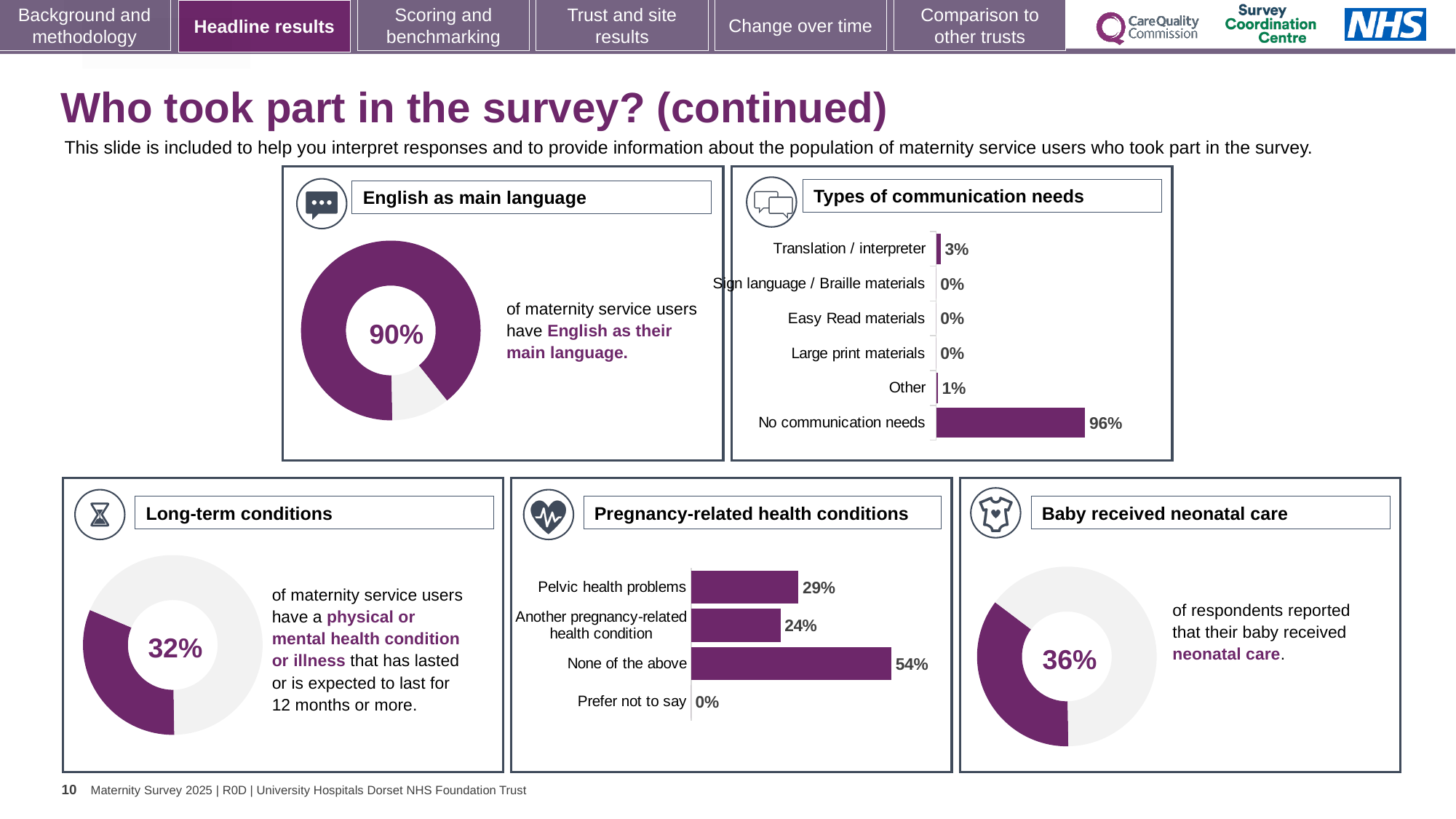
What kind of chart is the 'Pregnancy-related health conditions' chart? Bar chart In the 'Pregnancy-related health conditions' chart, which is larger: 'Pelvic health problems' or 'Another pregnancy-related health condition'? Pelvic health problems In the 'Types of communication needs' chart, what is the value for 'No communication needs'? 96% In the 'Types of communication needs' chart, what is the value for 'Translation / interpreter'? 3% In the 'Long-term conditions' chart, what percentage of maternity service users have a physical or mental health condition or illness? 32% How many categories are shown in the 'Types of communication needs' chart? 6 In the 'Pregnancy-related health conditions' chart, what is the value for 'Pelvic health problems'? 29% In the 'Types of communication needs' chart, which category has the highest value? No communication needs In the 'English as main language' chart, what percentage of maternity service users have English as their main language? 90% In the 'Baby received neonatal care' chart, what percentage of respondents reported that their baby received neonatal care? 36% In the 'Types of communication needs' chart, what is the difference between 'No communication needs' and 'Translation / interpreter'? 93% In the 'Pregnancy-related health conditions' chart, which category has the highest value? None of the above